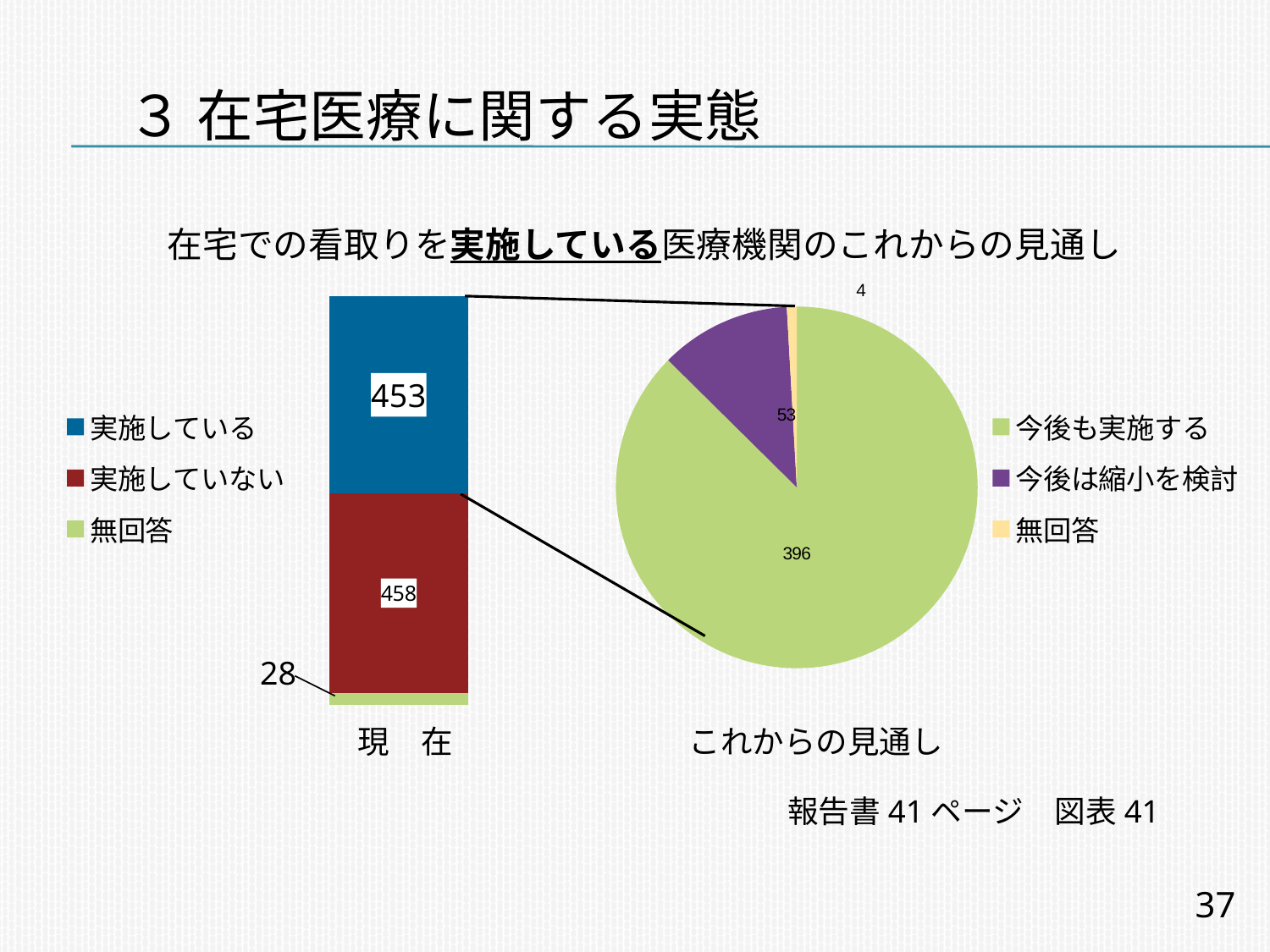
In the stacked bar chart on the left (現在), what is the value for 実施している? 453 In the stacked bar chart on the left (現在), how many series does the legend list? 3 In the pie chart on the right (これからの見通し), what is the value for 今後も実施する? 396 In the pie chart on the right (これからの見通し), which slice is the largest? 今後も実施する In the pie chart on the right (これからの見通し), what is the value for 今後は縮小を検討? 53 In the stacked bar chart on the left (現在), which segment is the smallest? 無回答 In the pie chart on the right (これからの見通し), what is the difference between 今後も実施する and 今後は縮小を検討? 343 In the stacked bar chart on the left (現在), what is the value for 実施していない? 458 In the stacked bar chart on the left (現在), what is the total of the stacked bar? 939 In the pie chart on the right (これからの見通し), what is the value for 無回答? 4 What kind of chart is shown on the right side of the slide (これからの見通し)? Pie chart In the stacked bar chart on the left (現在), what is the value for 無回答? 28